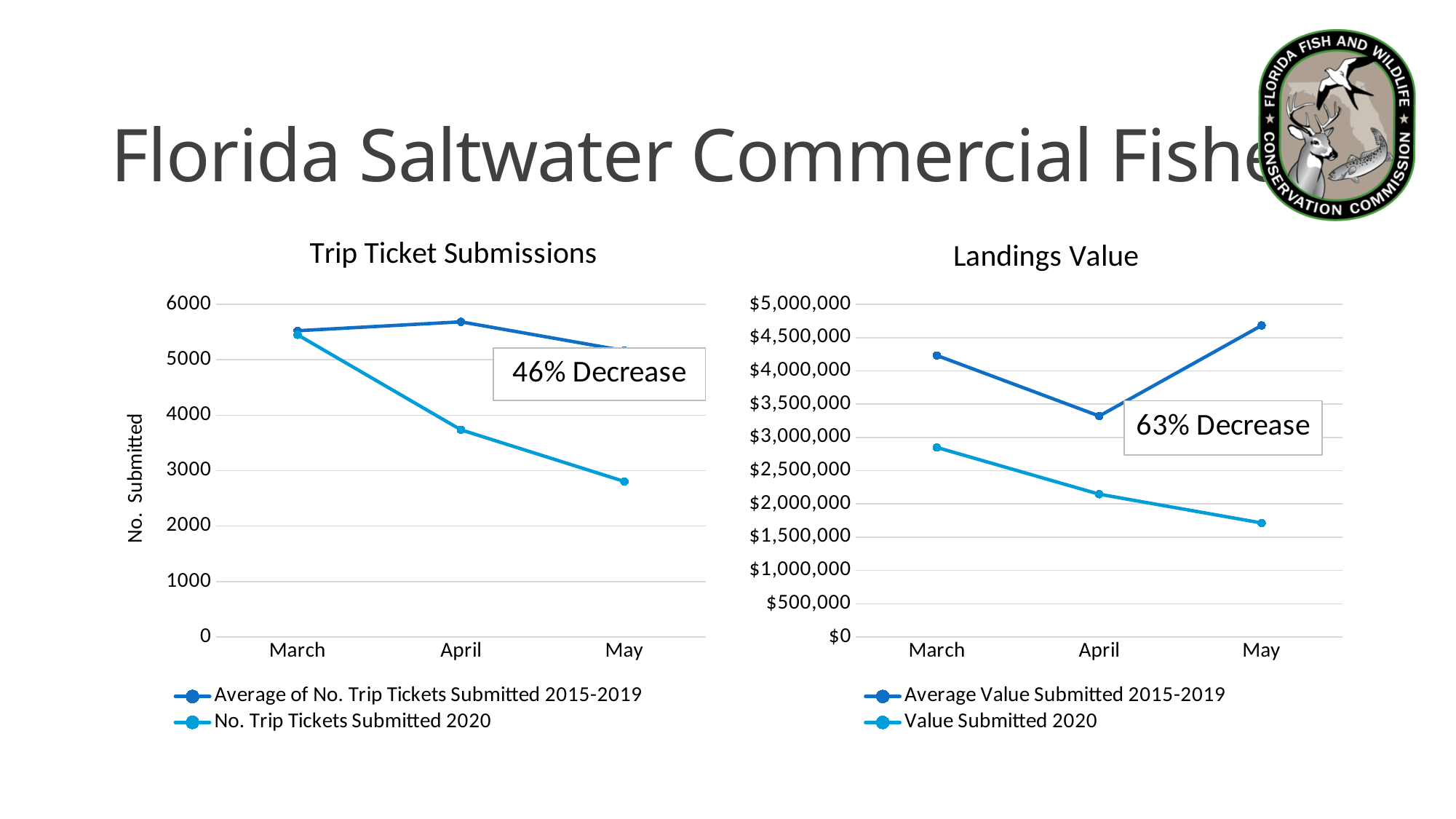
How many months are shown on the x axis of the Landings Value chart? 3 In the Landings Value chart, which is larger in April: Average Value Submitted 2015-2019 or Value Submitted 2020? Average Value Submitted 2015-2019 In the Landings Value chart, which month has the lowest value for Average Value Submitted 2015-2019? April What kind of chart is the Trip Ticket Submissions chart? Line chart What percentage decrease is annotated on the Landings Value chart? 63% Decrease In the Landings Value chart, which month has the highest value for Average Value Submitted 2015-2019? May In the Landings Value chart, is the value for Value Submitted 2020 in March greater or less than $3,000,000? less How many series does the legend of the Trip Ticket Submissions chart list? 2 In the Trip Ticket Submissions chart, is the value for No. Trip Tickets Submitted 2020 in May greater or less than 3000? less In the Trip Ticket Submissions chart, is the value for No. Trip Tickets Submitted 2020 in April greater or less than 4000? less In the Trip Ticket Submissions chart, do the values for No. Trip Tickets Submitted 2020 rise or fall from March to May? Fall In the Trip Ticket Submissions chart, which month has the lowest value for No. Trip Tickets Submitted 2020? May